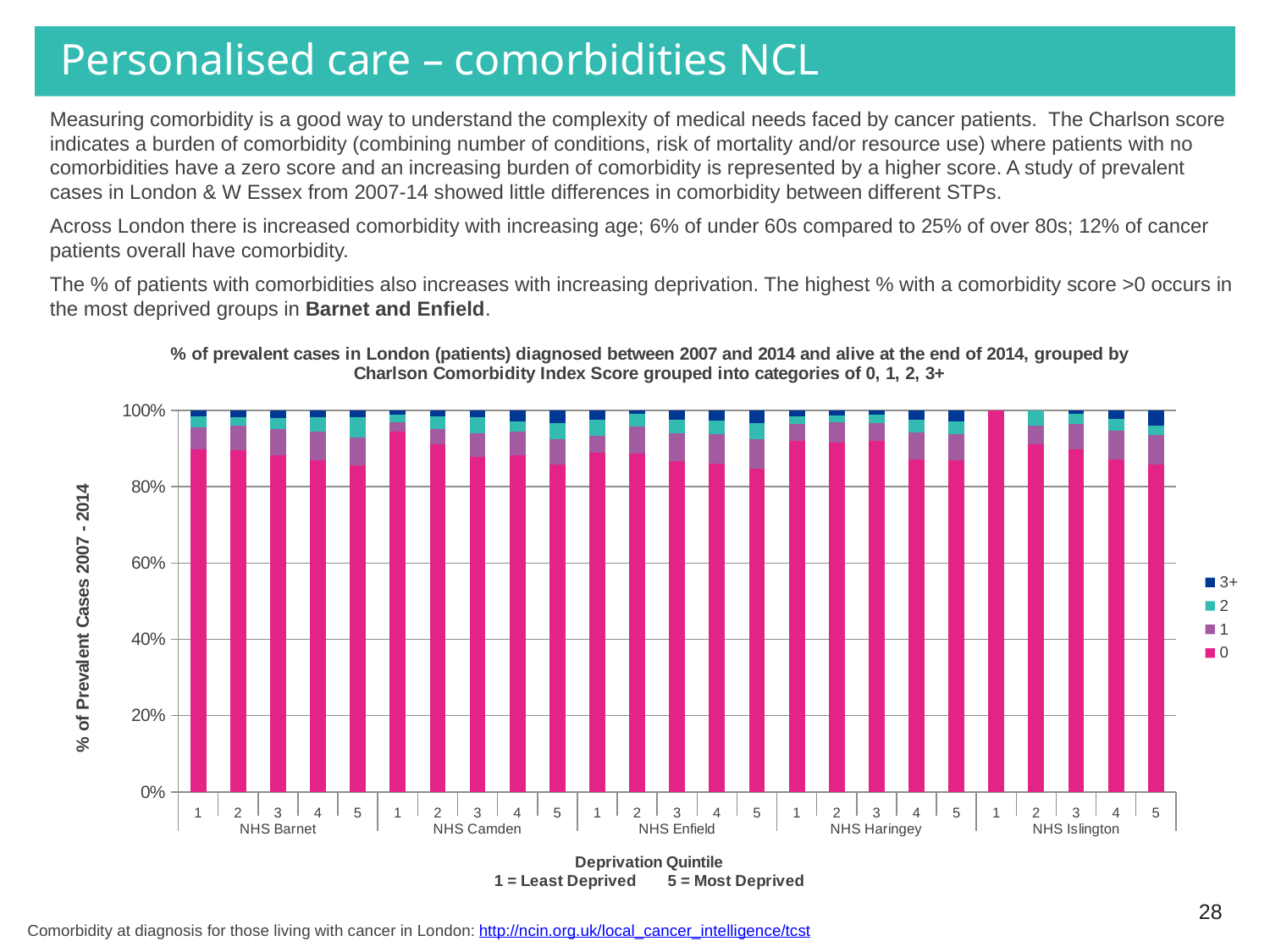
How many NHS areas are shown along the x axis of the chart? 5 Is the value of the '0' comorbidity score segment for NHS Barnet quintile 5 greater or less than 90%? less What kind of chart is shown on the slide? Stacked bar chart How many series does the chart legend list? 4 Is the value of the '0' comorbidity score segment for NHS Camden quintile 1 greater or less than 90%? greater Within NHS Camden, is the share of patients with a comorbidity score of 0 larger for quintile 1 or quintile 5? Quintile 1 Is the value of the '0' comorbidity score segment for NHS Enfield quintile 5 greater or less than 90%? less Within NHS Enfield, does the share of patients with a comorbidity score of 0 rise or fall from quintile 1 to quintile 5? Fall What is the total of the stacked bar for NHS Camden deprivation quintile 3? 100% How many bars are plotted in the chart? 25 What is the label on the y axis of the chart? % of Prevalent Cases 2007 - 2014 Within NHS Islington, which deprivation quintile has the highest share of patients with a comorbidity score of 0? 1